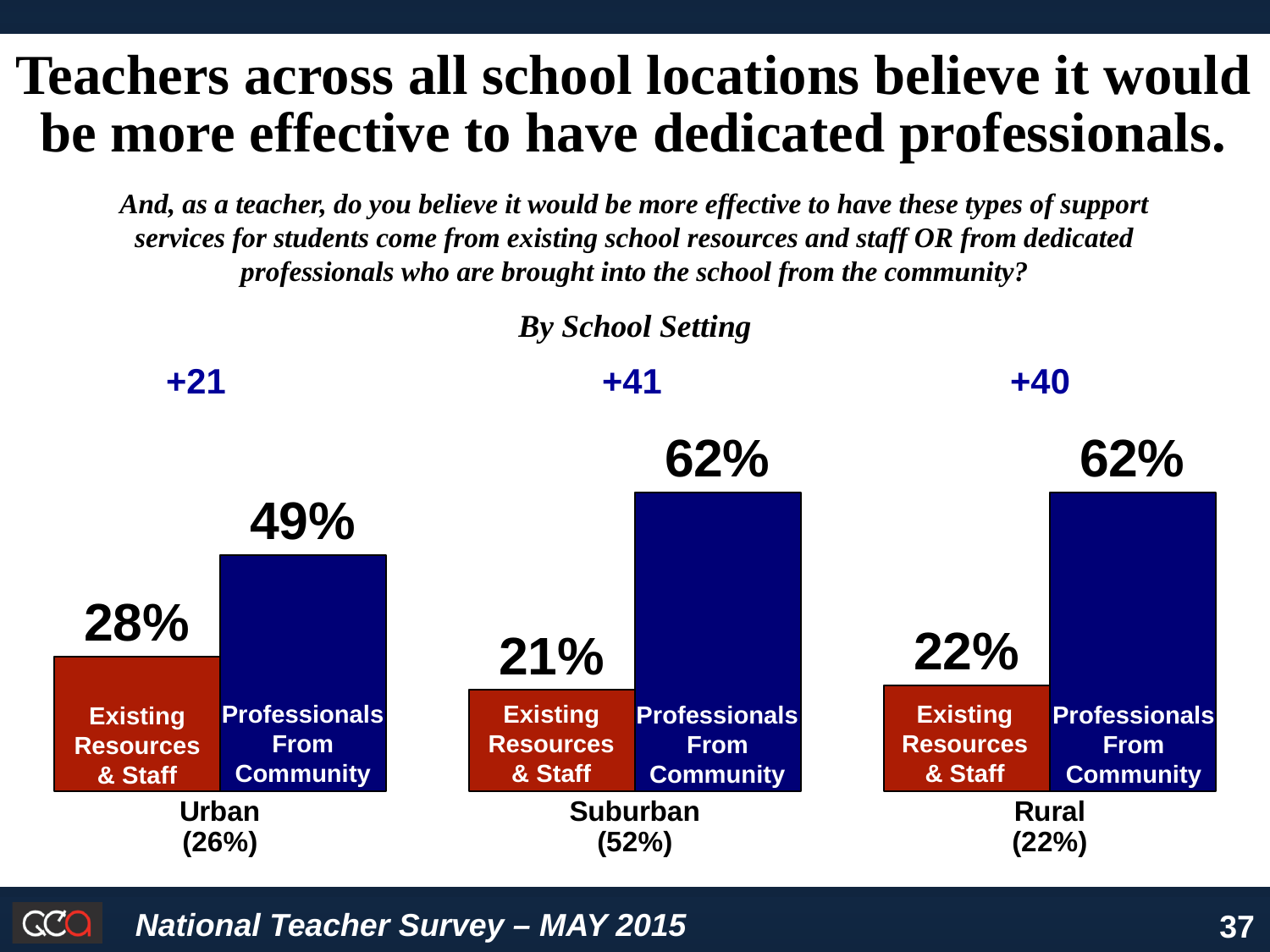
Across the three charts, which school setting has the highest value for Existing Resources & Staff? Urban In the Urban chart, what percentage of teachers chose Professionals From Community? 49% In the Urban chart, what percentage of teachers chose Existing Resources & Staff? 28% In the Urban chart, which bar is higher, Existing Resources & Staff or Professionals From Community? Professionals From Community How many bars are shown in the Suburban chart? 2 In the Rural chart, what is the difference between the Professionals From Community value and the Existing Resources & Staff value? 40 What colour are the Professionals From Community bars? Blue In the Suburban chart, what is the difference between the Professionals From Community value and the Existing Resources & Staff value? 41 In the Rural chart, what percentage of teachers chose Professionals From Community? 62% In the Suburban chart, what percentage of teachers chose Existing Resources & Staff? 21% What kind of chart is used to show the results for each school setting? Bar chart Across the three charts, which school setting has the lowest value for Existing Resources & Staff? Suburban